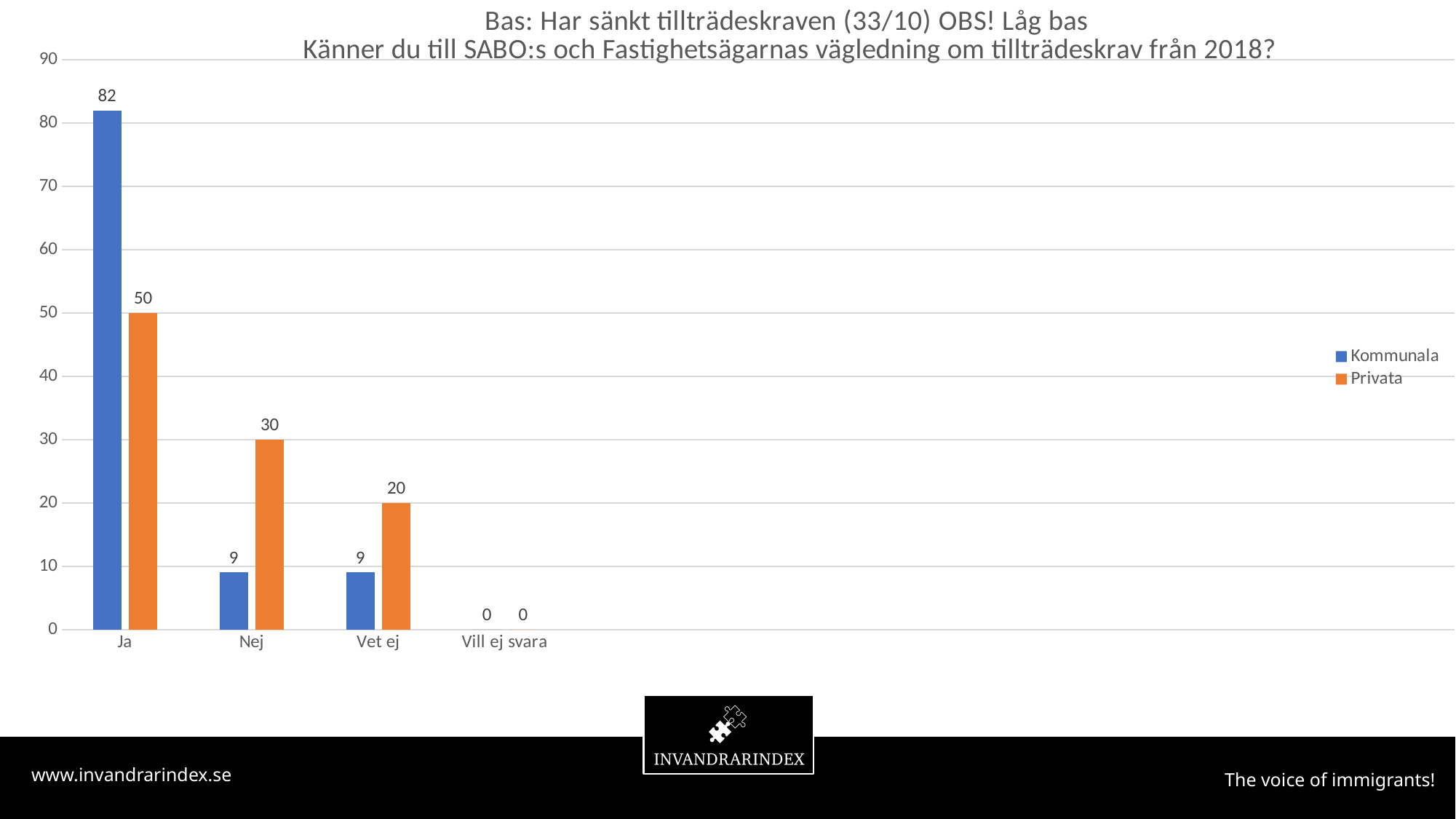
What is the difference between the Kommunala and Privata values in the Ja category? 32 Is the value for Kommunala in the Ja category greater or less than 80? greater Which category has the lowest value for Kommunala? Vill ej svara What is the value for Kommunala in the Ja category? 82 What kind of chart is shown on the slide? Bar chart How many series does the legend list? 2 What is the value for Privata in the Nej category? 30 Which is larger in the Nej category, Kommunala or Privata? Privata Which colour represents the Privata series? Orange What is the value for Privata in the Vet ej category? 20 How many categories are shown on the x axis? 4 Which category has the highest value for Privata? Ja